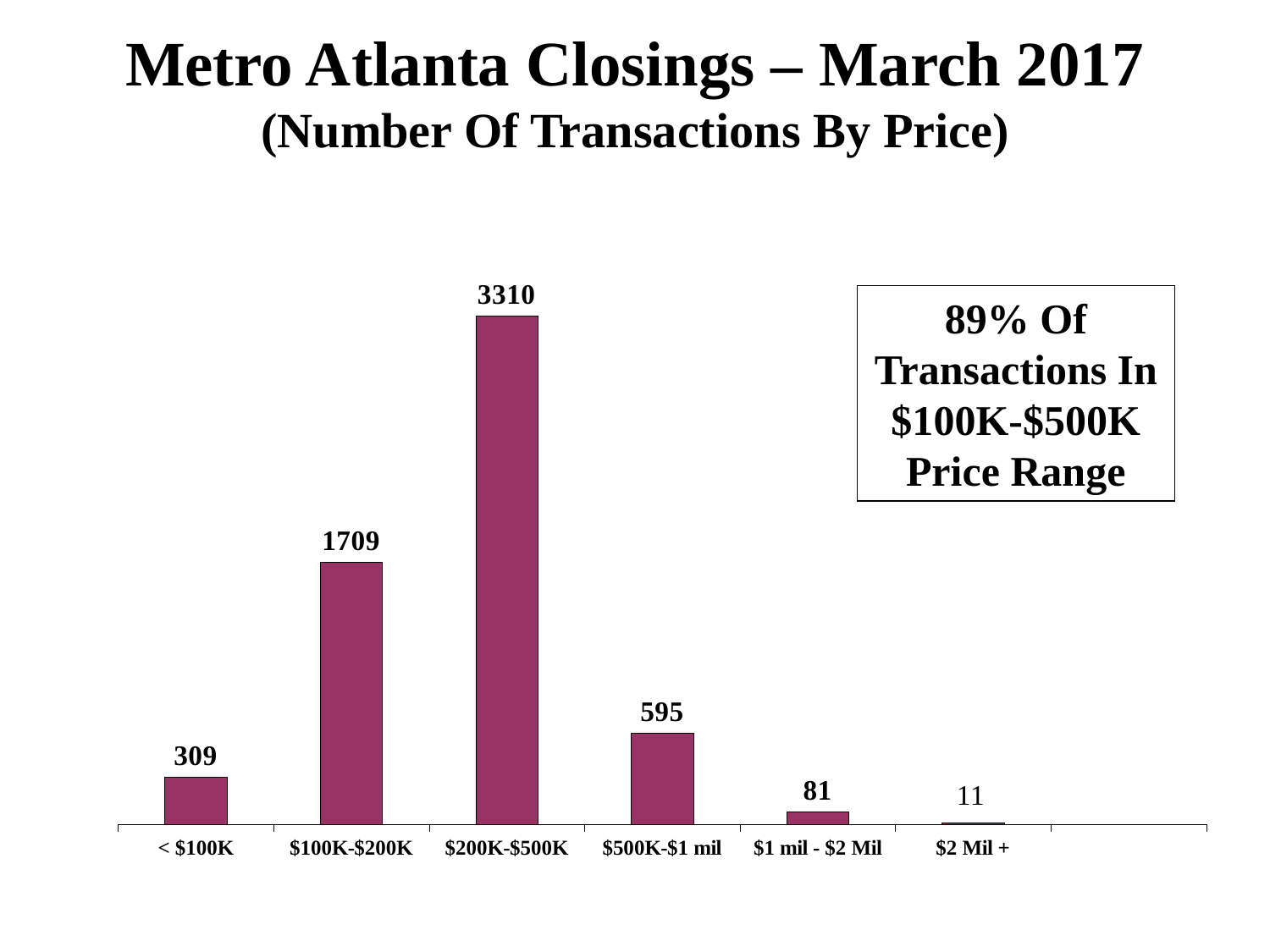
Which price range has the lowest number of transactions? $2 Mil + Which is larger, the value for $100K-$200K or the value for $500K-$1 mil? $100K-$200K What is the difference between the $200K-$500K and $100K-$200K values? 1601 What is the value for the $1 mil - $2 Mil category? 81 How many price range categories are shown on the chart? 6 What is the title of the chart on the slide? Metro Atlanta Closings – March 2017 (Number Of Transactions By Price) According to the text box on the slide, what percentage of transactions were in the $100K-$500K price range? 89% How many transactions were in the < $100K price range? 309 Which price range has the highest number of transactions? $200K-$500K What is the difference between the $500K-$1 mil and < $100K values? 286 What kind of chart is shown on the slide? bar chart How many transactions were in the $200K-$500K price range? 3310